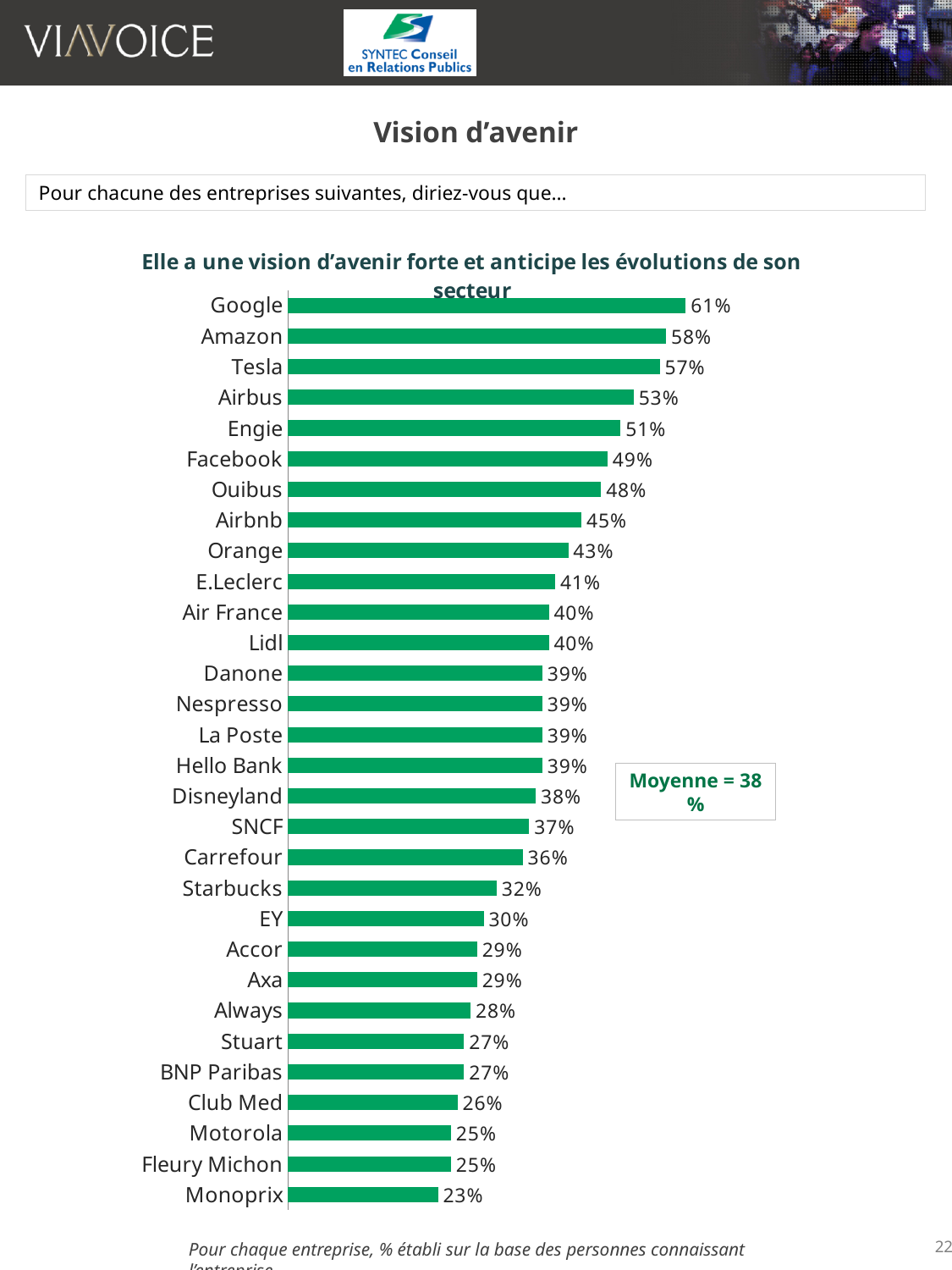
What is the difference between the values for Amazon and Tesla? 1% What average (Moyenne) is indicated on the chart? 38 % Which has a higher value, Starbucks or EY? Starbucks What percentage is shown for Google? 61% What is the difference between the values for Google and Monoprix? 38% Which company has the highest value? Google How many companies are shown in the chart? 30 Which has a higher value, Facebook or Airbnb? Facebook Which company has the lowest value? Monoprix What kind of chart is this? bar chart What percentage is shown for Fleury Michon? 25% What is the value for Carrefour? 36%